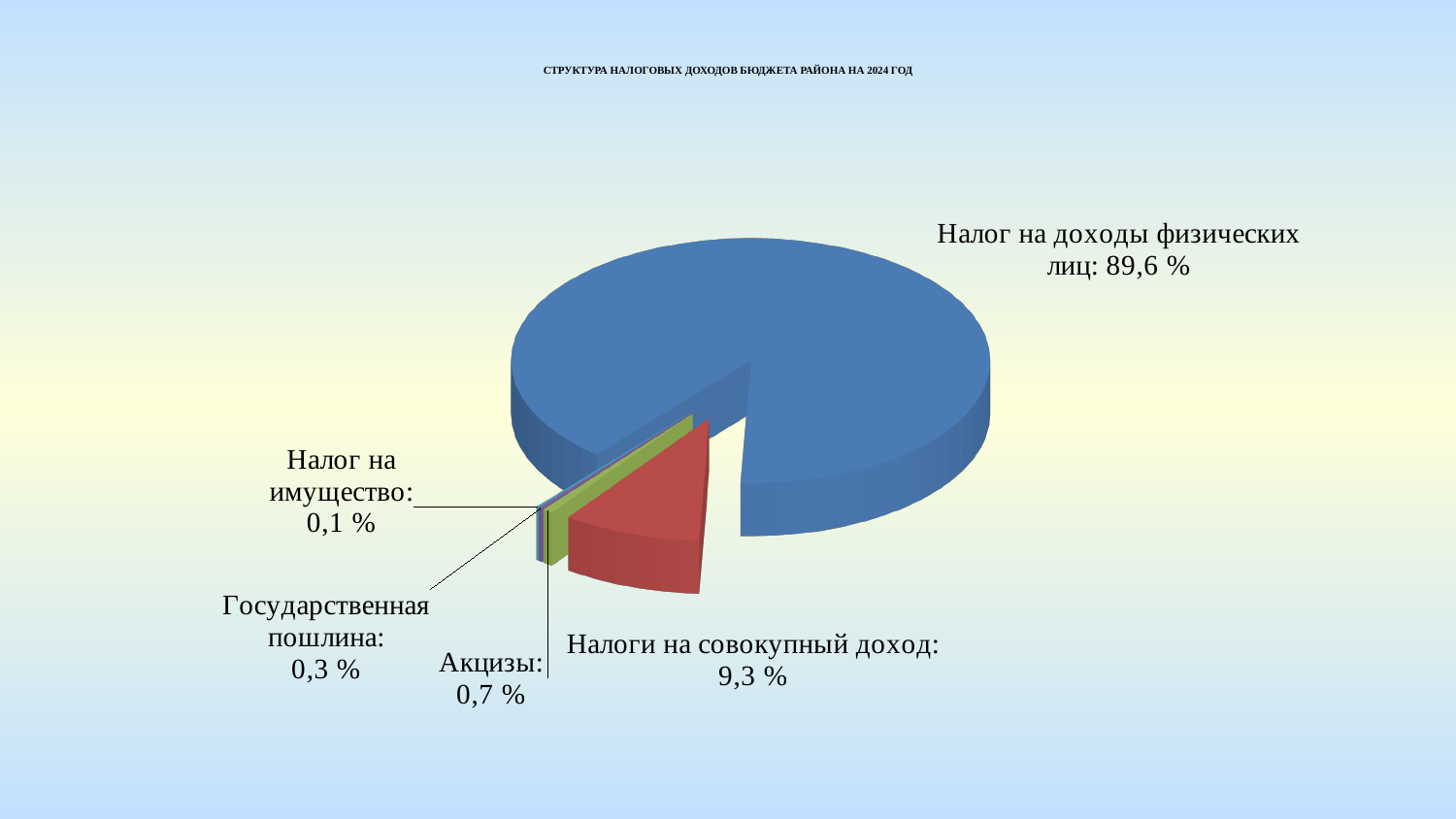
What value is shown for "Налоги на совокупный доход"? 9,3 % What is the difference between the shares of "Налог на доходы физических лиц" and "Налоги на совокупный доход"? 80,3 % How many slices does the pie chart have? 5 What value is shown for "Акцизы"? 0,7 % What value is shown for "Налог на имущество"? 0,1 % What value is shown for "Государственная пошлина"? 0,3 % Which category has the largest share of the pie? Налог на доходы физических лиц What is the title of the chart on the slide? СТРУКТУРА НАЛОГОВЫХ ДОХОДОВ БЮДЖЕТА РАЙОНА НА 2024 ГОД What type of chart is shown on the slide? Pie chart Which category has the smallest share of the pie? Налог на имущество What share of the pie is labelled for "Налог на доходы физических лиц"? 89,6 % Which is larger: the share for "Акцизы" or the share for "Государственная пошлина"? Акцизы